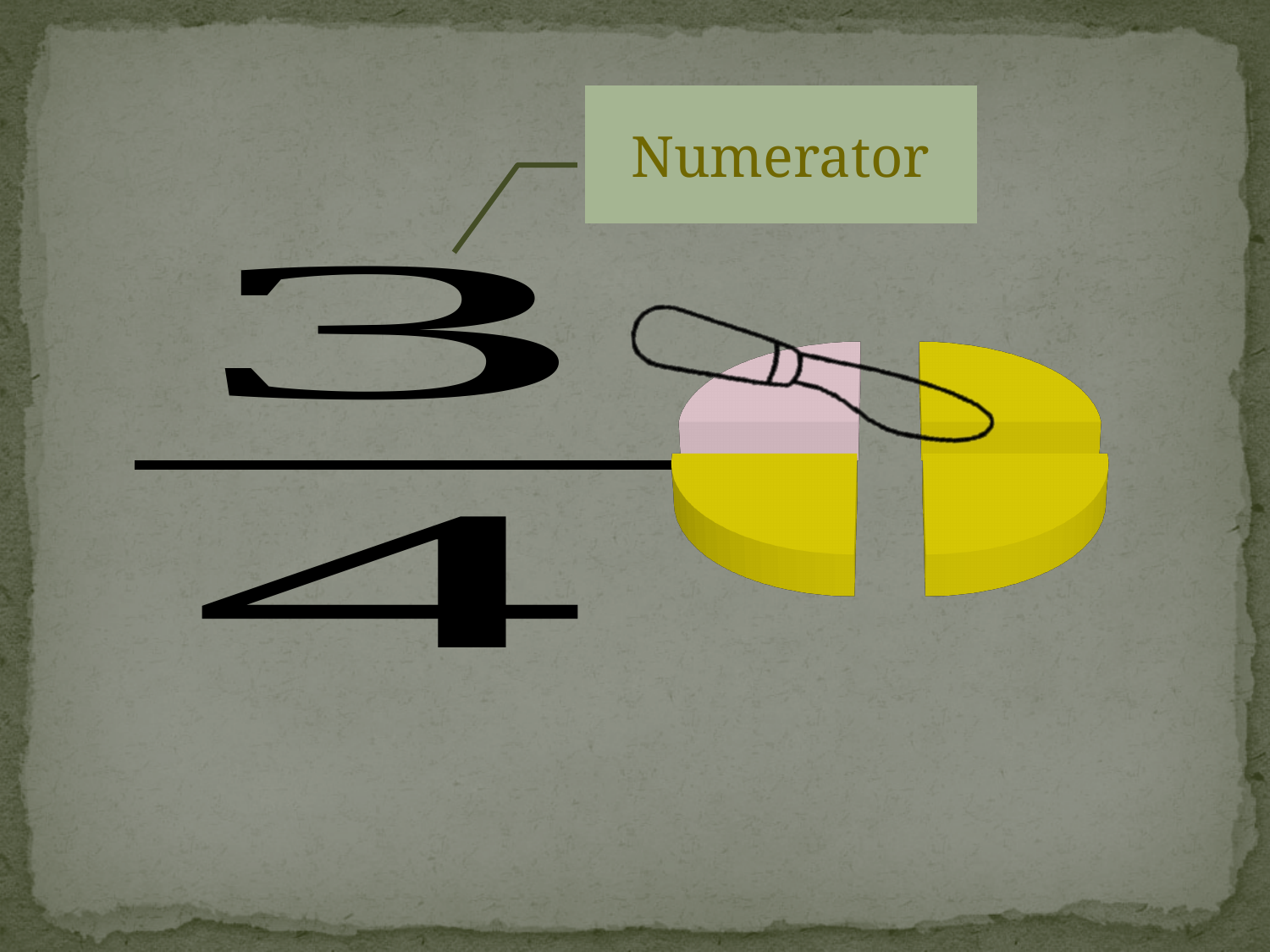
What kind of chart is shown on the slide? pie chart What colour is the single slice that differs from the others in the pie chart? pink How many slices of the pie chart are yellow? 3 What fraction of the pie chart do the yellow slices represent, as written on the slide? 3/4 How many slices does the pie chart have? 4